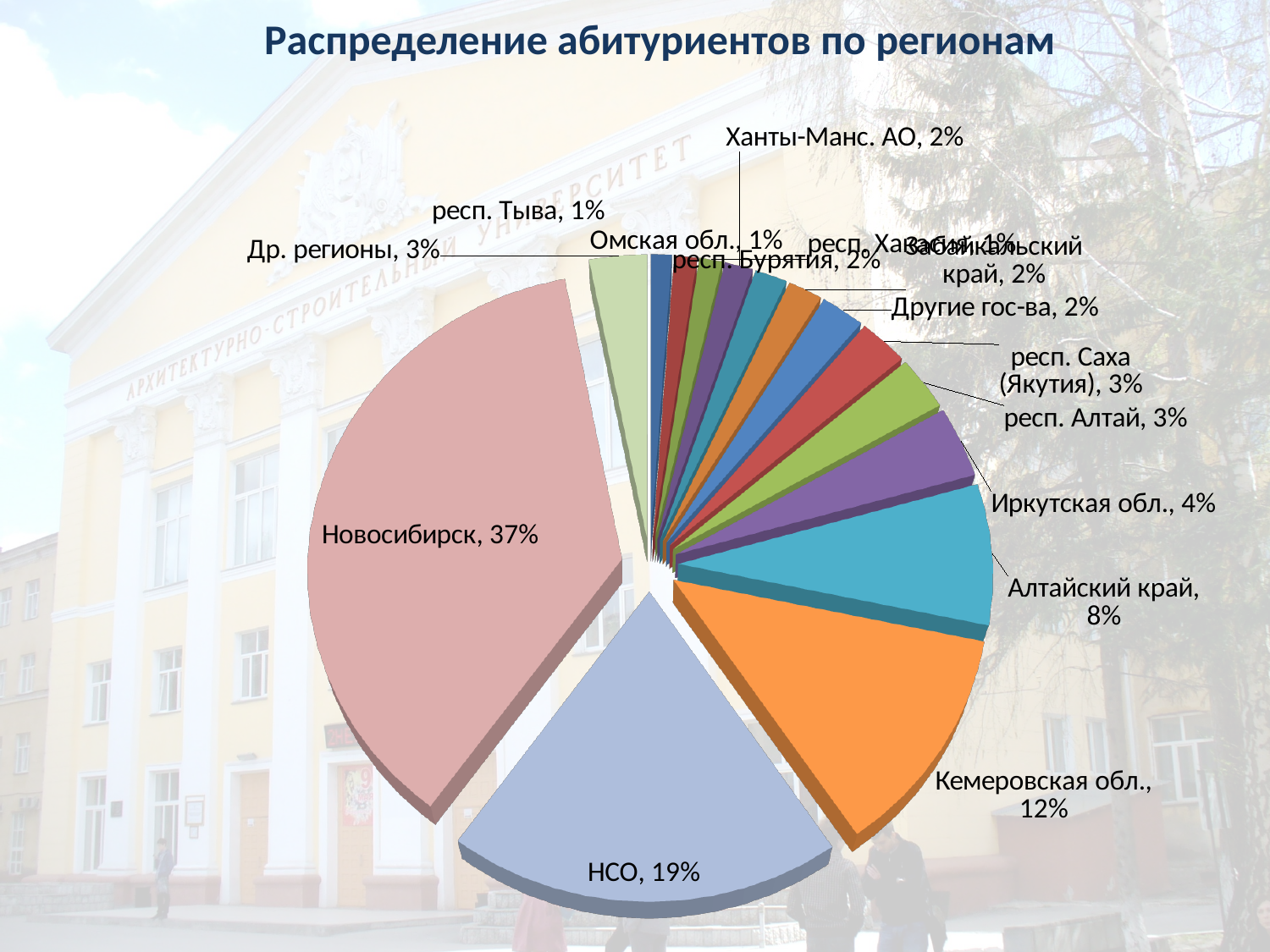
What share of the pie does Алтайский край have? 8% What share of the pie does Иркутская обл. have? 4% Which region has the largest share of the pie? Новосибирск What share of the pie does Кемеровская обл. have? 12% What is the title of the chart? Распределение абитуриентов по регионам What is the difference in percentage points between Новосибирск and НСО? 18 What kind of chart is shown on the slide? pie chart What share of the pie does Новосибирск have? 37% What share of the pie does НСО have? 19% Which is larger, the share for Кемеровская обл. or the share for Алтайский край? Кемеровская обл. What share of the pie does Ханты-Манс. АО have? 2% What is the difference in percentage points between Алтайский край and Иркутская обл.? 4